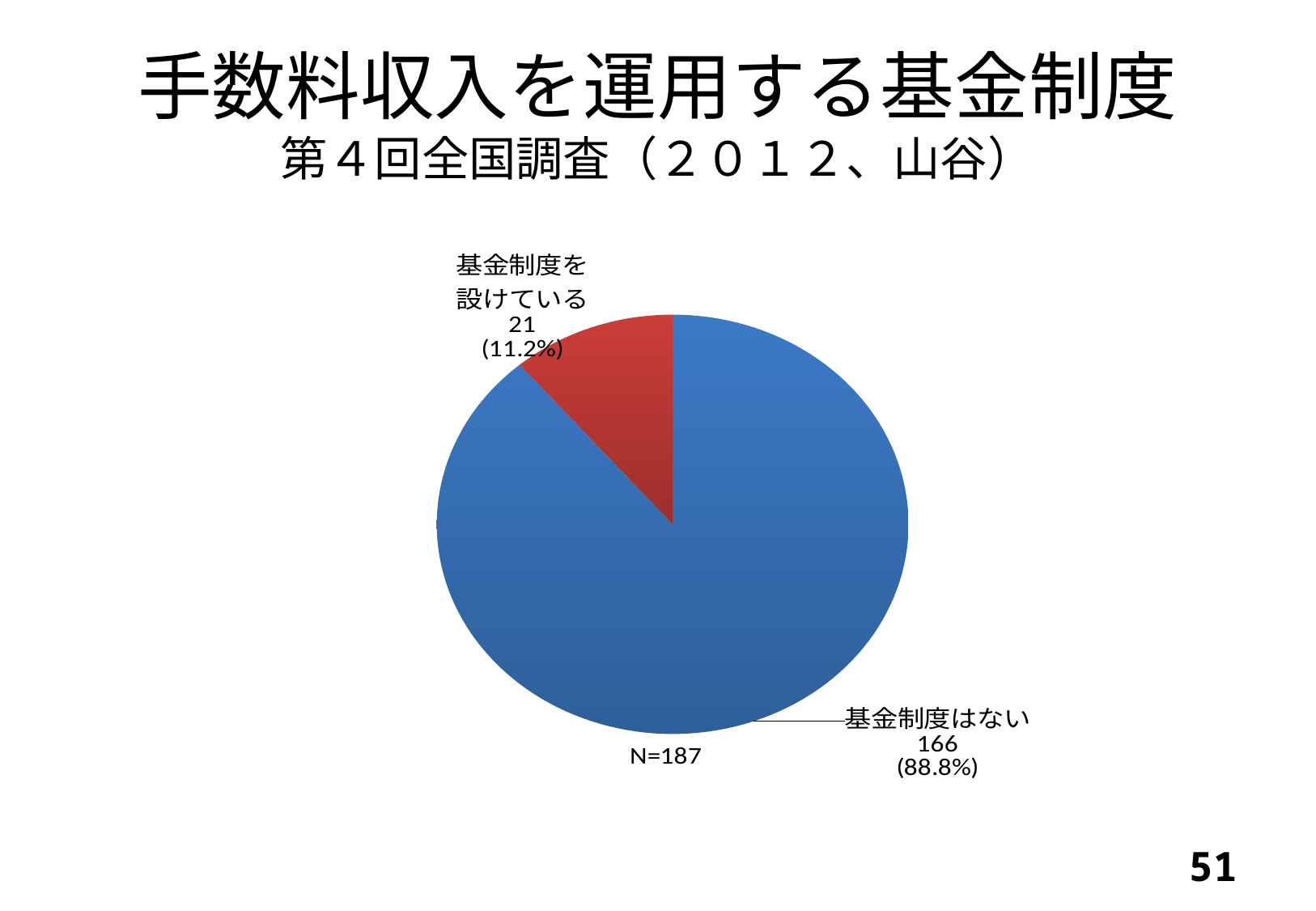
What is the difference between the counts for 基金制度はない and 基金制度を設けている? 145 What share of the pie does 基金制度はない represent? 88.8% What is the count for 基金制度はない? 166 Which is larger, the count for 基金制度はない or for 基金制度を設けている? 基金制度はない What is the total N shown below the pie chart? N=187 What kind of chart is shown on the slide? pie chart What is the count for 基金制度を設けている? 21 Which category has the smallest slice? 基金制度を設けている How many slices does the pie chart have? 2 What colour is the slice for 基金制度を設けている? red What share of the pie does 基金制度を設けている represent? 11.2% Which category has the largest slice? 基金制度はない